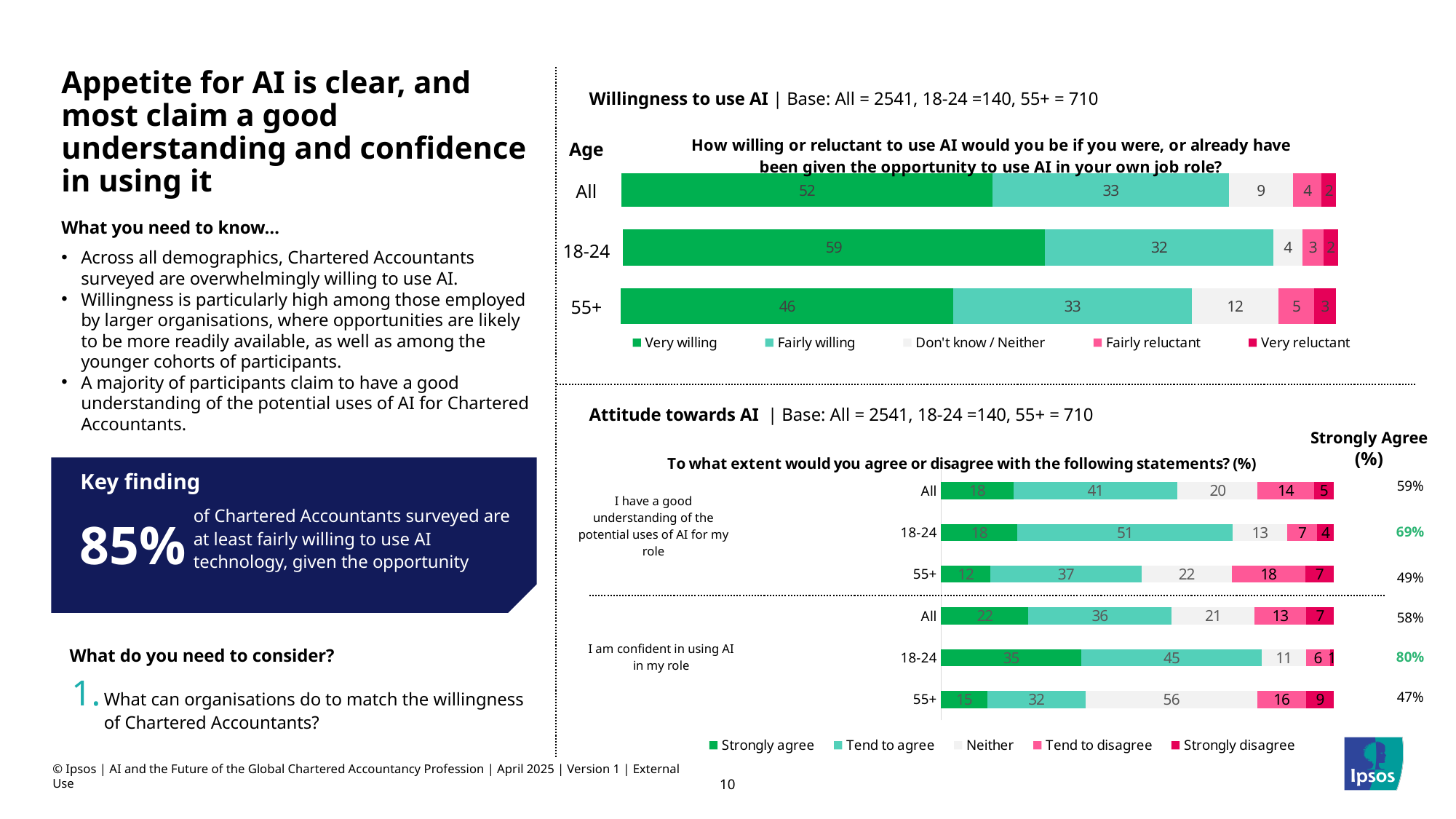
In the Willingness to use AI chart, what percentage of the All group are Very willing? 52 In the Attitude towards AI chart, what is the difference between the Strongly Agree (%) figures for 18-24 and 55+ on 'I am confident in using AI in my role'? 33% In the Willingness to use AI chart, which age group has the lowest Very willing value? 55+ In the Willingness to use AI chart, how many series does the legend list? 5 In the Attitude towards AI chart, is the Strongly agree value for All on 'I am confident in using AI in my role' larger or smaller than the Strongly agree value for 55+ on the same statement? Larger In the Attitude towards AI chart, what is the Strongly Agree (%) figure for 18-24 on 'I am confident in using AI in my role'? 80% In the Willingness to use AI chart, which age group has the highest Very willing value? 18-24 In the Willingness to use AI chart, what is the difference between the Very willing values for 18-24 and 55+? 13 What kind of chart is the Willingness to use AI chart? Stacked bar chart In the Attitude towards AI chart, which age group has the lowest Strongly Agree (%) for 'I have a good understanding of the potential uses of AI for my role'? 55+ In the Willingness to use AI chart, what is the Fairly willing value for the 18-24 age group? 32 In the Attitude towards AI chart, what is the Tend to agree value for 18-24 on 'I have a good understanding of the potential uses of AI for my role'? 51